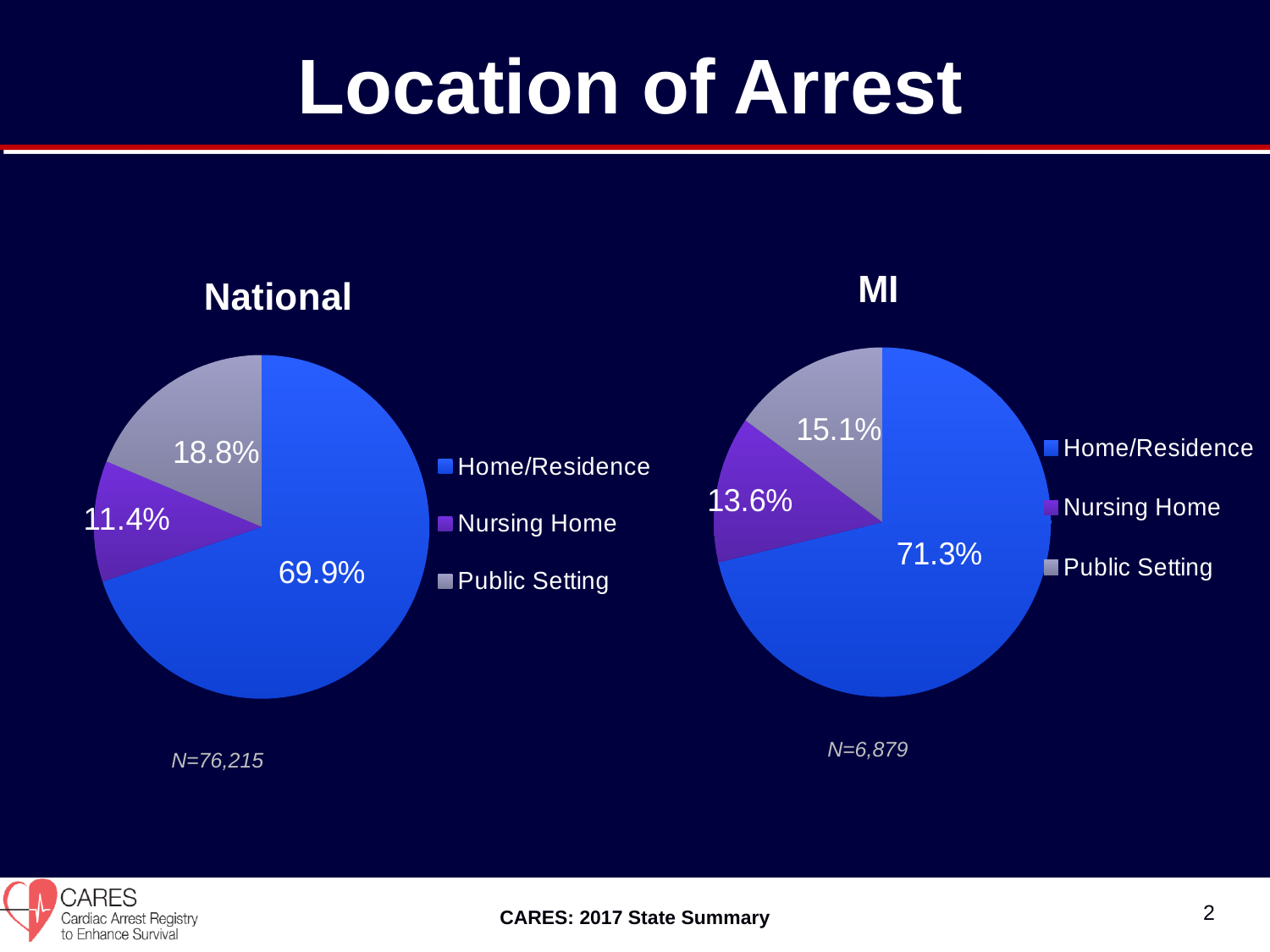
In the National pie chart, what share of arrests occurred at Home/Residence? 69.9% What type of chart is used for the National data? Pie chart In the MI pie chart, which location has the smallest share? Nursing Home In the MI pie chart, what share of arrests occurred in a Public Setting? 15.1% In the National pie chart, which location has the smallest share? Nursing Home In the National pie chart, what share of arrests occurred in a Public Setting? 18.8% In the National pie chart, which location has the largest share? Home/Residence How many slices does the MI pie chart have? 3 What is the N value shown below the MI pie chart? N=6,879 Which chart shows a larger Public Setting share, National or MI? National What is the difference between the Home/Residence share in the MI chart and in the National chart? 1.4% In the MI pie chart, what share of arrests occurred in a Nursing Home? 13.6%